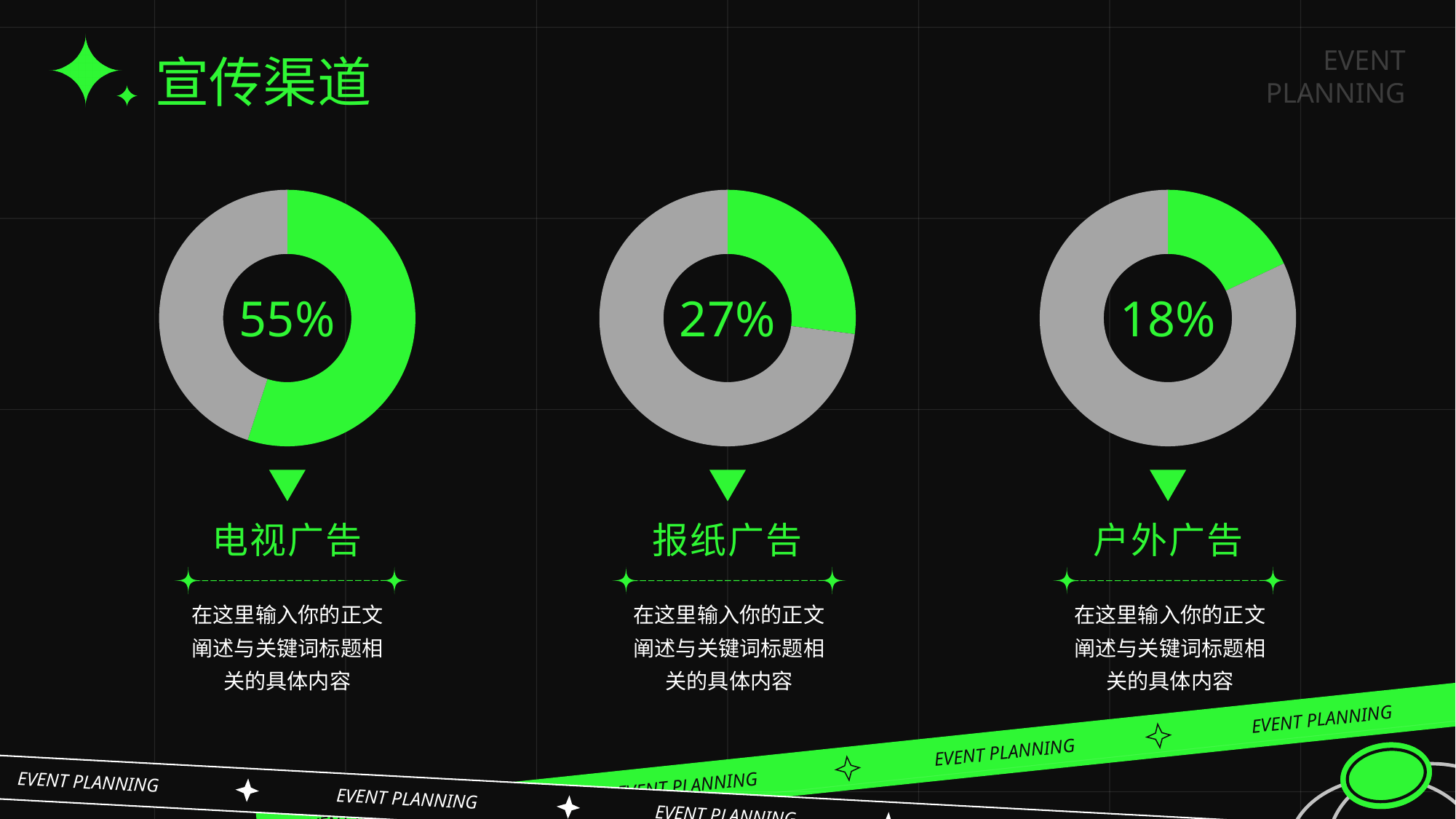
What is the difference between the percentage for 电视广告 and the percentage for 报纸广告? 28% What percentage is shown in the donut chart for 报纸广告? 27% What is the difference between the percentage for 报纸广告 and the percentage for 户外广告? 9% What percentage is shown in the donut chart for 电视广告? 55% Which of the three channels (电视广告, 报纸广告, 户外广告) has the highest percentage? 电视广告 What is the title of the slide containing the three donut charts? 宣传渠道 Which of the three channels (电视广告, 报纸广告, 户外广告) has the lowest percentage? 户外广告 What kind of chart is used to show the percentage for each channel on the slide? Donut chart How many donut charts are shown on the slide? 3 Which is larger, the percentage for 报纸广告 or the percentage for 户外广告? 报纸广告 What colour is the highlighted (value) segment in each donut chart? Green What percentage is shown in the donut chart for 户外广告? 18%